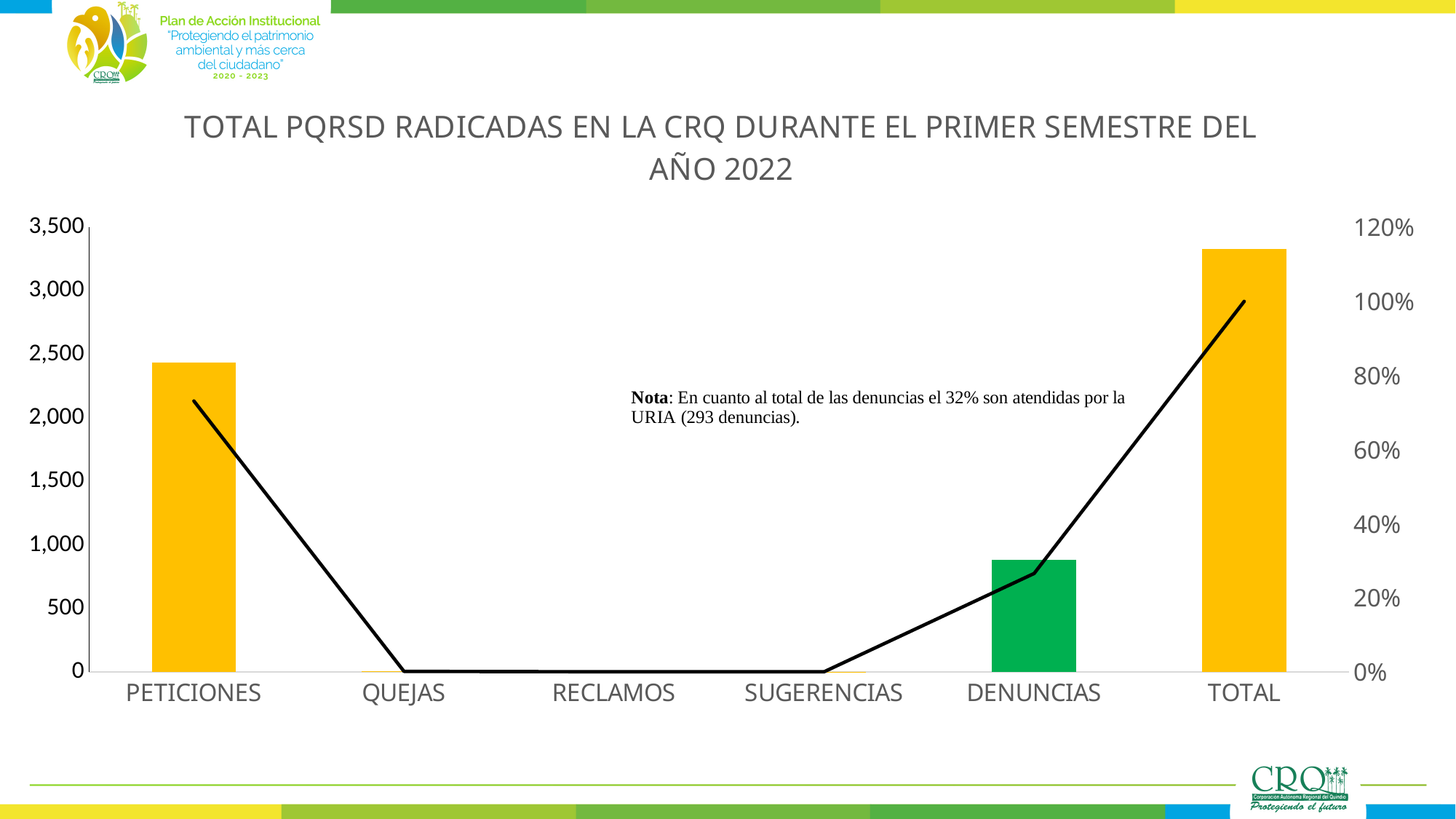
Excluding TOTAL, which category has the tallest bar? PETICIONES Is the bar value for TOTAL greater or less than 3,000? greater What is the title of the chart? TOTAL PQRSD RADICADAS EN LA CRQ DURANTE EL PRIMER SEMESTRE DEL AÑO 2022 Which bar is taller, PETICIONES or DENUNCIAS? PETICIONES What colour is the bar for DENUNCIAS? green What kind of chart is shown on the slide? bar chart with a line Is the bar value for DENUNCIAS greater or less than 1,000? less Which category has the tallest bar in the chart? TOTAL How many categories are shown on the x axis of the chart? 6 Is the line value for PETICIONES on the right axis greater or less than 60%? greater What percentage does the line reach at TOTAL on the right axis? 100%